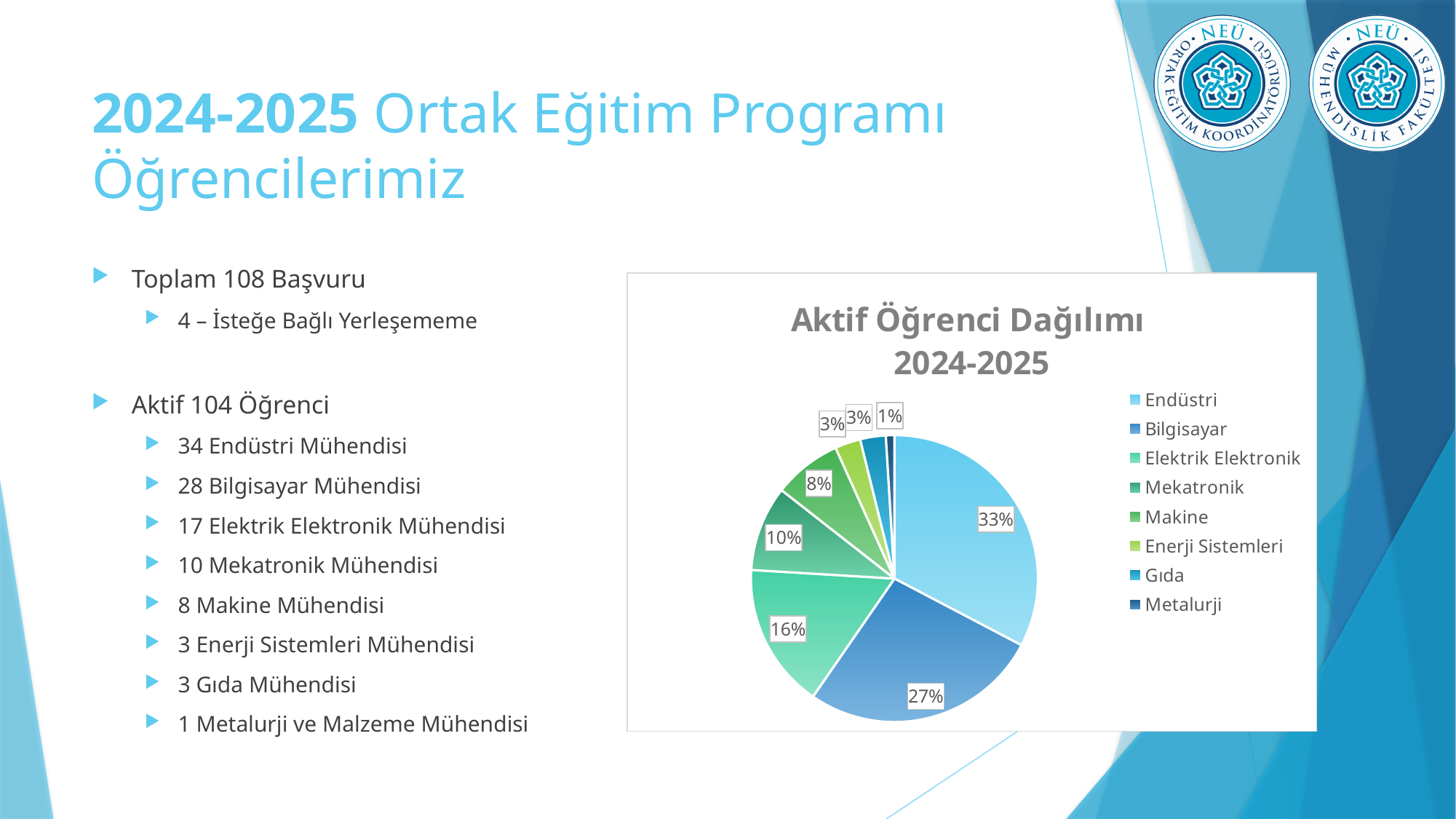
What is the title of the chart? Aktif Öğrenci Dağılımı 2024-2025 What percentage is shown for Makine? 8% What percentage is shown for Mekatronik? 10% Which category has the largest slice of the pie? Endüstri What share of the pie is labelled for Bilgisayar? 27% How many categories does the legend list? 8 Which is larger, the share for Makine or the share for Mekatronik? Mekatronik Which category has the smallest slice of the pie? Metalurji What percentage is shown for Elektrik Elektronik? 16% What is the difference in percentage points between Endüstri and Bilgisayar? 6 What percentage of the pie does Endüstri account for? 33% What type of chart is shown on the slide? Pie chart